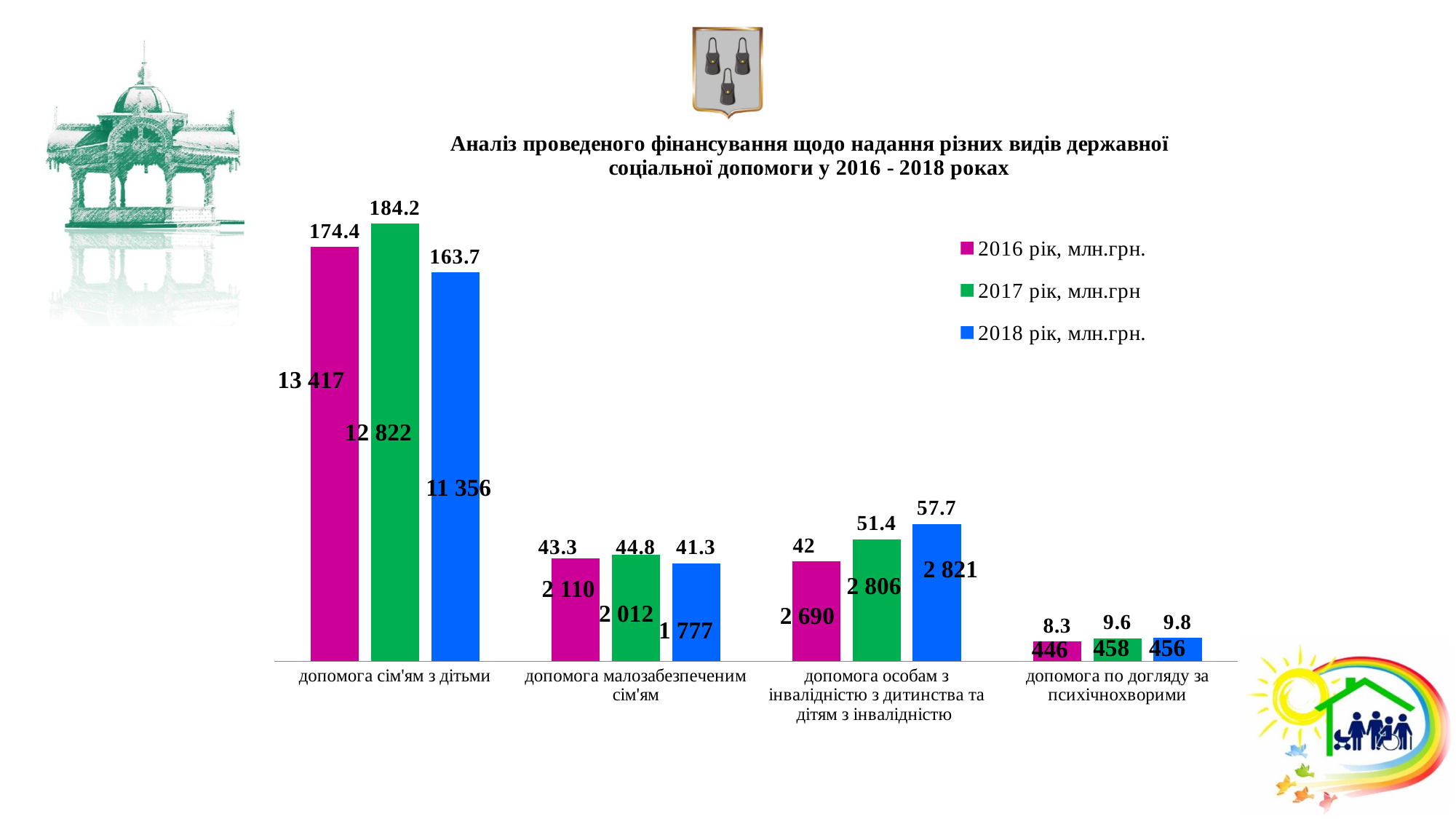
Which colour represents the 2018 series in the legend? blue How many series does the legend list? 3 How many categories are shown on the x axis? 4 Which category has the lowest 2018 value? допомога по догляду за психічнохворими What is the 2017 value (млн.грн) for "допомога сім'ям з дітьми"? 184.2 What kind of chart is shown on the slide? bar chart What is the difference between the 2017 and 2018 values for "допомога сім'ям з дітьми"? 20.5 What number is printed inside the 2018 bar for "допомога малозабезпеченим сім'ям"? 1 777 What is the 2018 value (млн.грн) for "допомога особам з інвалідністю з дитинства та дітям з інвалідністю"? 57.7 Which is larger for "допомога особам з інвалідністю з дитинства та дітям з інвалідністю": the 2016 value or the 2017 value? 2017 value Which category has the highest 2016 value? допомога сім'ям з дітьми What is the 2016 value (млн.грн) for "допомога по догляду за психічнохворими"? 8.3